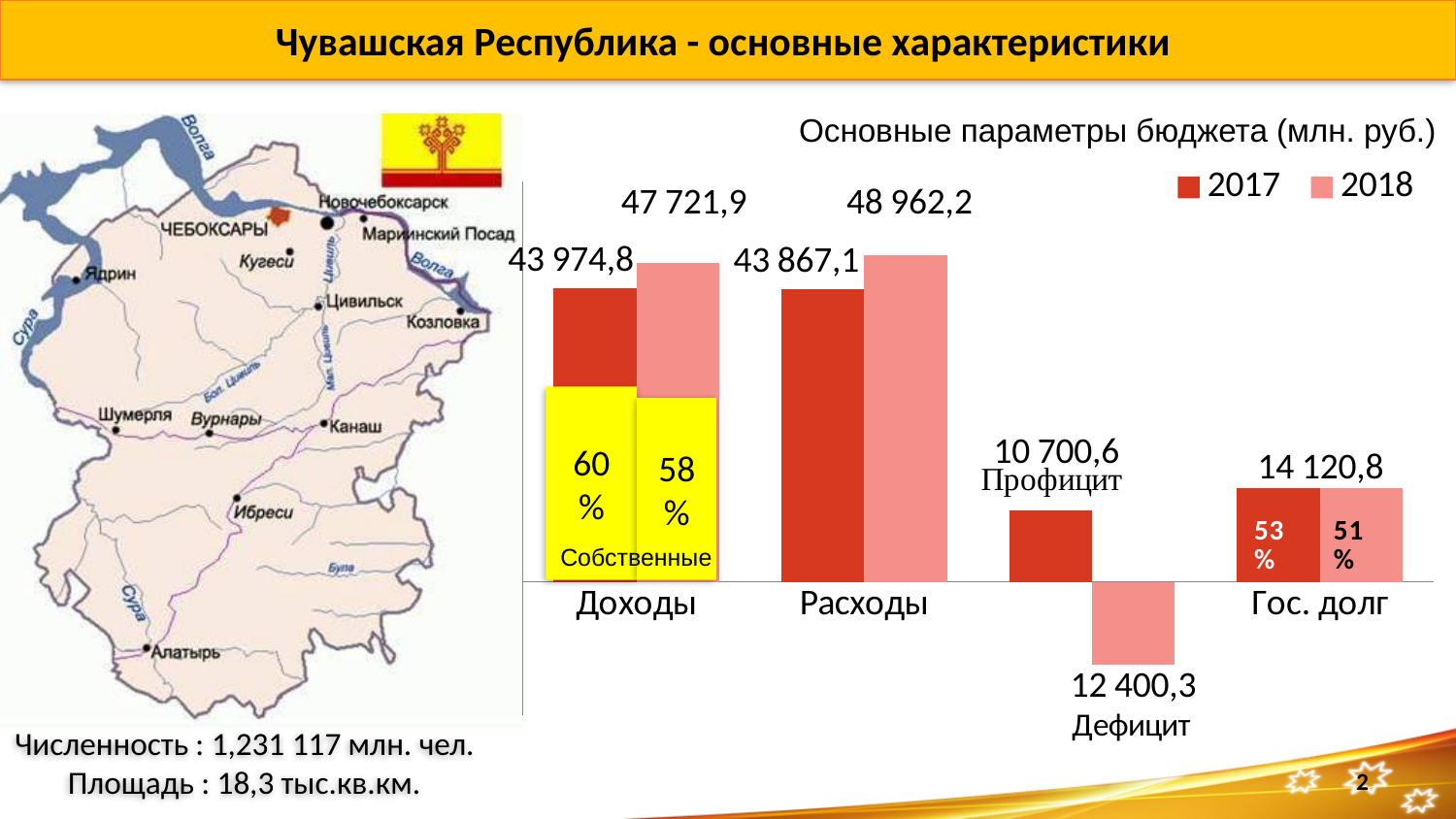
In the chart 'Основные параметры бюджета (млн. руб.)', by how much did Расходы in 2018 exceed Расходы in 2017? 5 095,1 In the chart 'Основные параметры бюджета (млн. руб.)', by how much did Доходы in 2018 exceed Доходы in 2017? 3 747,1 In the chart 'Основные параметры бюджета (млн. руб.)', what is the value of the Профицит for 2017? 10 700,6 In the chart 'Основные параметры бюджета (млн. руб.)', what is the value of Доходы for 2018? 47 721,9 In the chart 'Основные параметры бюджета (млн. руб.)', what is the value of Расходы for 2017? 43 867,1 In the chart 'Основные параметры бюджета (млн. руб.)', what is the value of the Дефицит for 2018? 12 400,3 What kind of chart is 'Основные параметры бюджета (млн. руб.)'? bar chart In the chart 'Основные параметры бюджета (млн. руб.)', what is the value of Доходы for 2017? 43 974,8 In the chart 'Основные параметры бюджета (млн. руб.)', what is the value of Расходы for 2018? 48 962,2 How many series does the legend of the chart 'Основные параметры бюджета (млн. руб.)' list? 2 In the chart 'Основные параметры бюджета (млн. руб.)', what share of Доходы is marked as Собственные for 2017? 60% In the chart 'Основные параметры бюджета (млн. руб.)', which is larger for 2018: Доходы or Расходы? Расходы